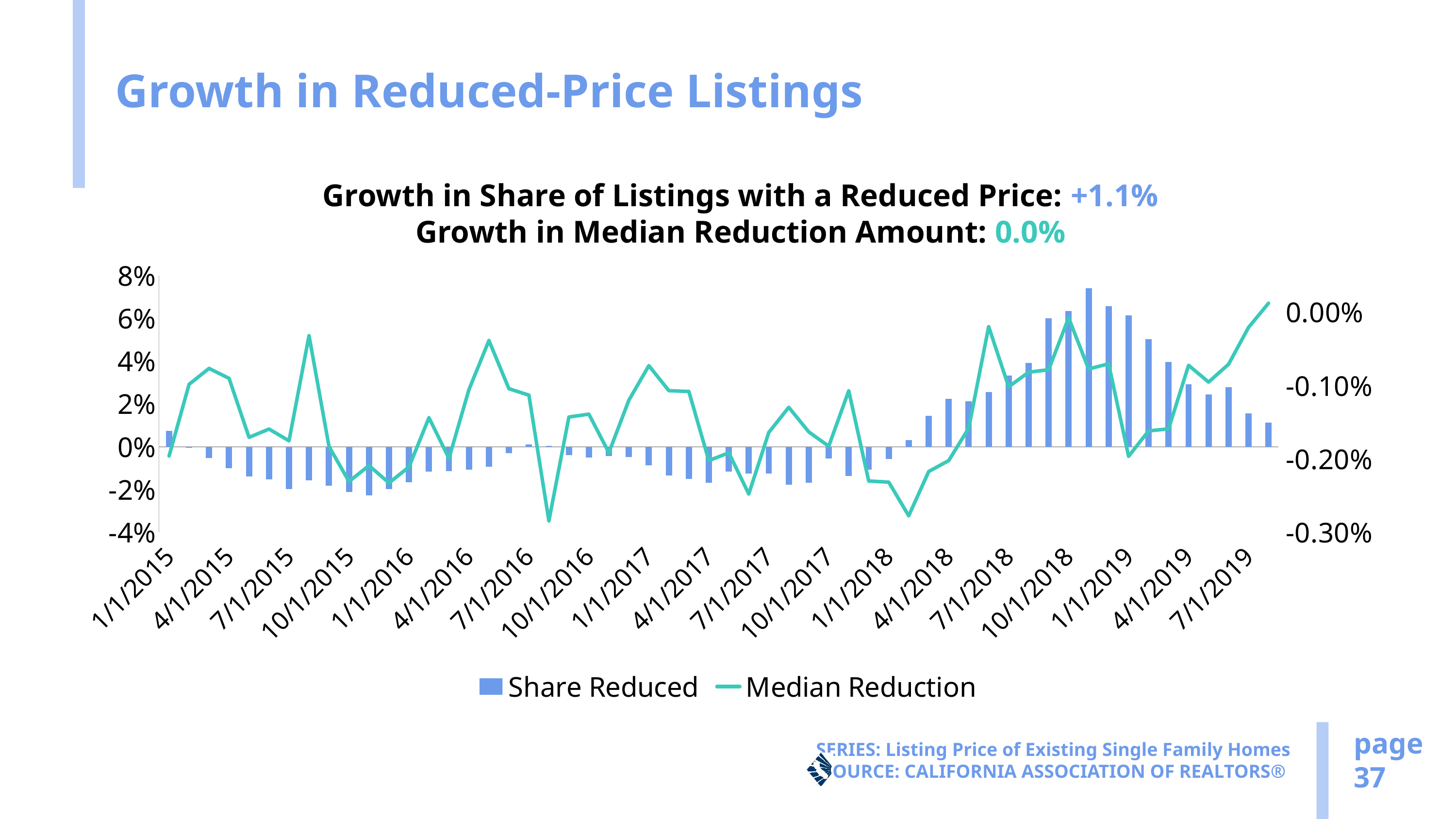
Is the Median Reduction value for 7/1/2019 greater or less than -0.10%? greater How many date labels are shown on the x axis? 19 Is the Median Reduction value for 10/1/2016 greater or less than -0.20%? greater Do the Share Reduced bars rise or fall from 4/1/2018 to 10/1/2018? rise How many series does the legend list? 2 Which series is drawn as a line in the chart? Median Reduction Is the Share Reduced value for 1/1/2016 greater or less than 0%? less Which is larger, the Share Reduced value for 1/1/2019 or for 1/1/2015? 1/1/2019 According to the chart title, what is the growth in median reduction amount? 0.0% What kind of chart is shown on the slide? A combined bar and line chart According to the chart title, what is the growth in share of listings with a reduced price? +1.1%